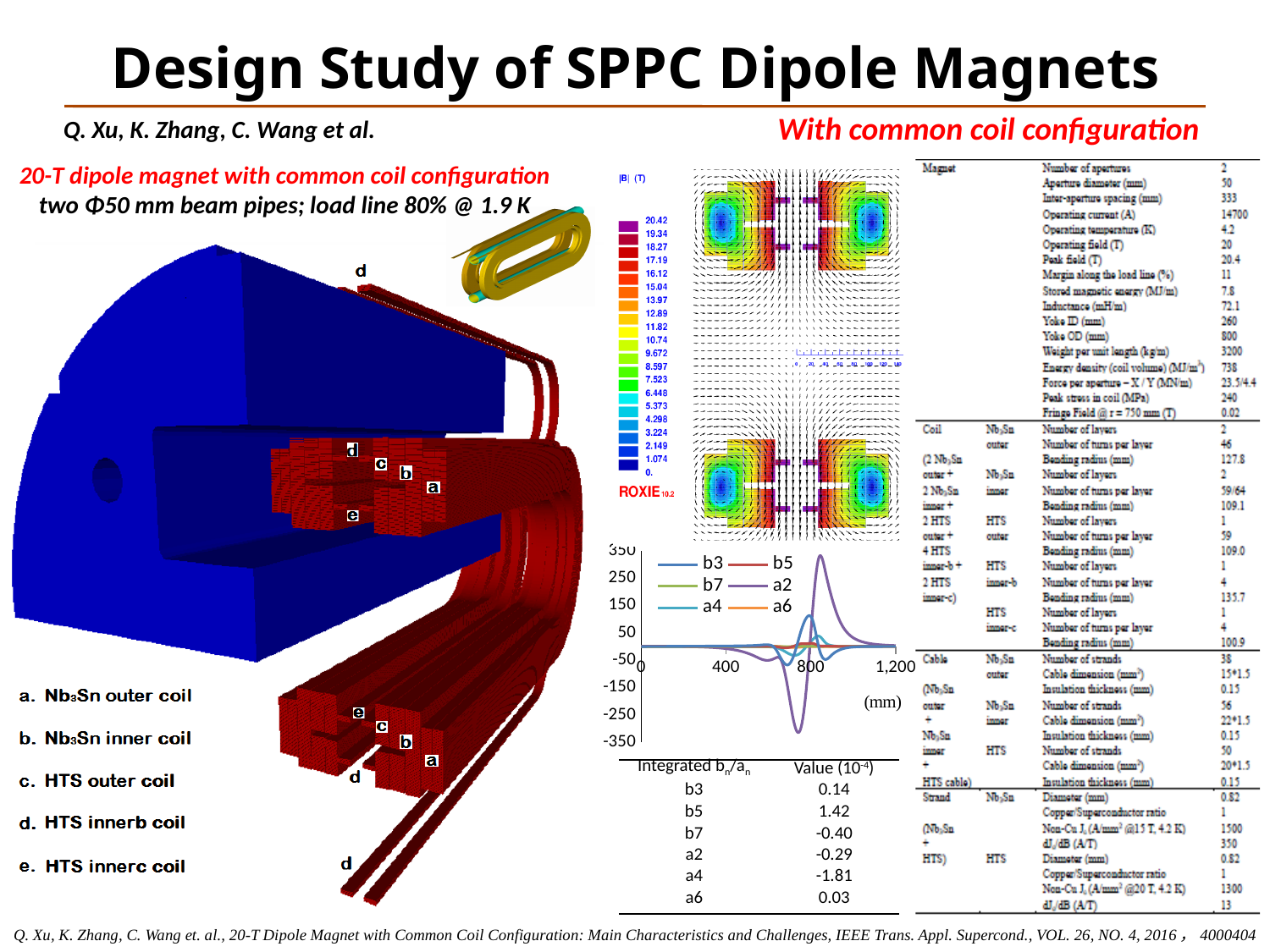
How many series does the legend of the line chart list? 6 What is the highest tick value shown on the vertical axis of the line chart? 350 What kind of chart is the plot with the legend entries b3, b5, b7, a2, a4 and a6? line chart In the line chart, is the minimum value of the a2 series greater or less than -250? less Which series in the line chart reaches the highest peak value? a2 In the line chart, is the peak value of the a4 series greater or less than 250? less Which series in the line chart reaches the lowest (most negative) value? a2 In the line chart, which series has the larger peak, a2 or a4? a2 What is the largest tick value shown on the horizontal axis of the line chart? 1,200 In the line chart, is the peak value of the a2 series greater or less than 250? greater